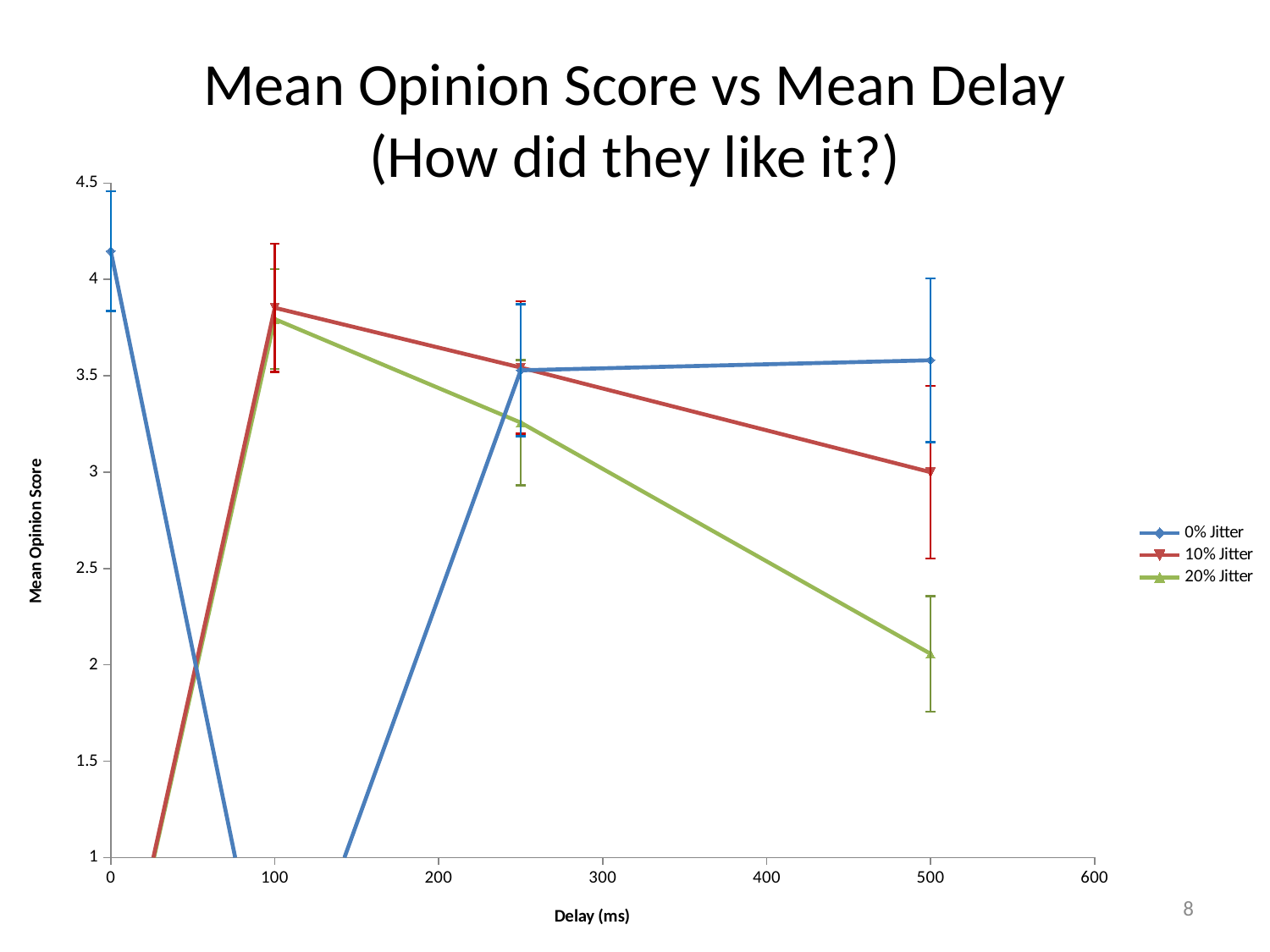
How many series does the legend list? 3 Is the value for 10% Jitter at 500 ms delay greater or less than 3.5? less At 500 ms delay, which is larger: the value for 10% Jitter or the value for 20% Jitter? 10% Jitter Is the value for 0% Jitter at 0 ms delay greater or less than 4? greater At 500 ms delay, which series has the highest Mean Opinion Score? 0% Jitter Does the 20% Jitter line rise or fall as delay increases from 100 ms to 500 ms? fall Is the value for 10% Jitter at 100 ms delay greater or less than 3.5? greater What is the title of the x axis? Delay (ms) What are the three series named in the legend? 0% Jitter, 10% Jitter, 20% Jitter At 500 ms delay, which series has the lowest Mean Opinion Score? 20% Jitter What kind of chart is shown on the slide? line chart